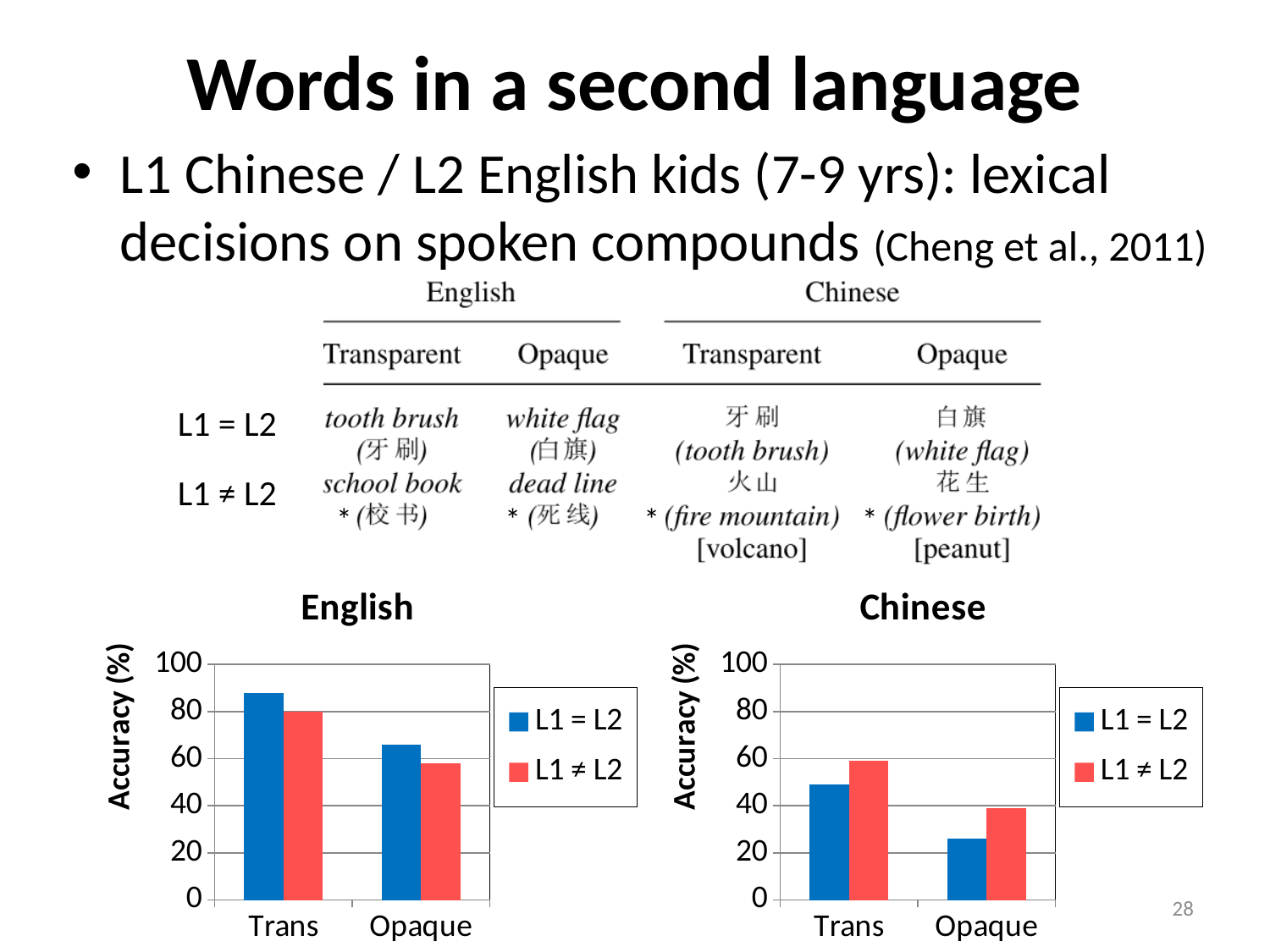
In the Chinese chart, is the L1 = L2 value for Opaque greater or less than 40? less In the English chart, which category has the highest L1 ≠ L2 accuracy? Trans In the Chinese chart, which category has the lowest L1 = L2 accuracy? Opaque In the English chart, is the L1 = L2 value for Trans greater or less than 80? greater In the English chart, how many categories are shown on the x axis? 2 In the Chinese chart, what is the label on the y axis? Accuracy (%) In the English chart, what kind of chart is shown? bar chart In the Chinese chart, is the L1 ≠ L2 value for Trans greater or less than 40? greater In the Chinese chart, which is larger for Trans: L1 = L2 or L1 ≠ L2? L1 ≠ L2 In the English chart, which is larger for Opaque: L1 = L2 or L1 ≠ L2? L1 = L2 In the Chinese chart, how many series does the legend list? 2